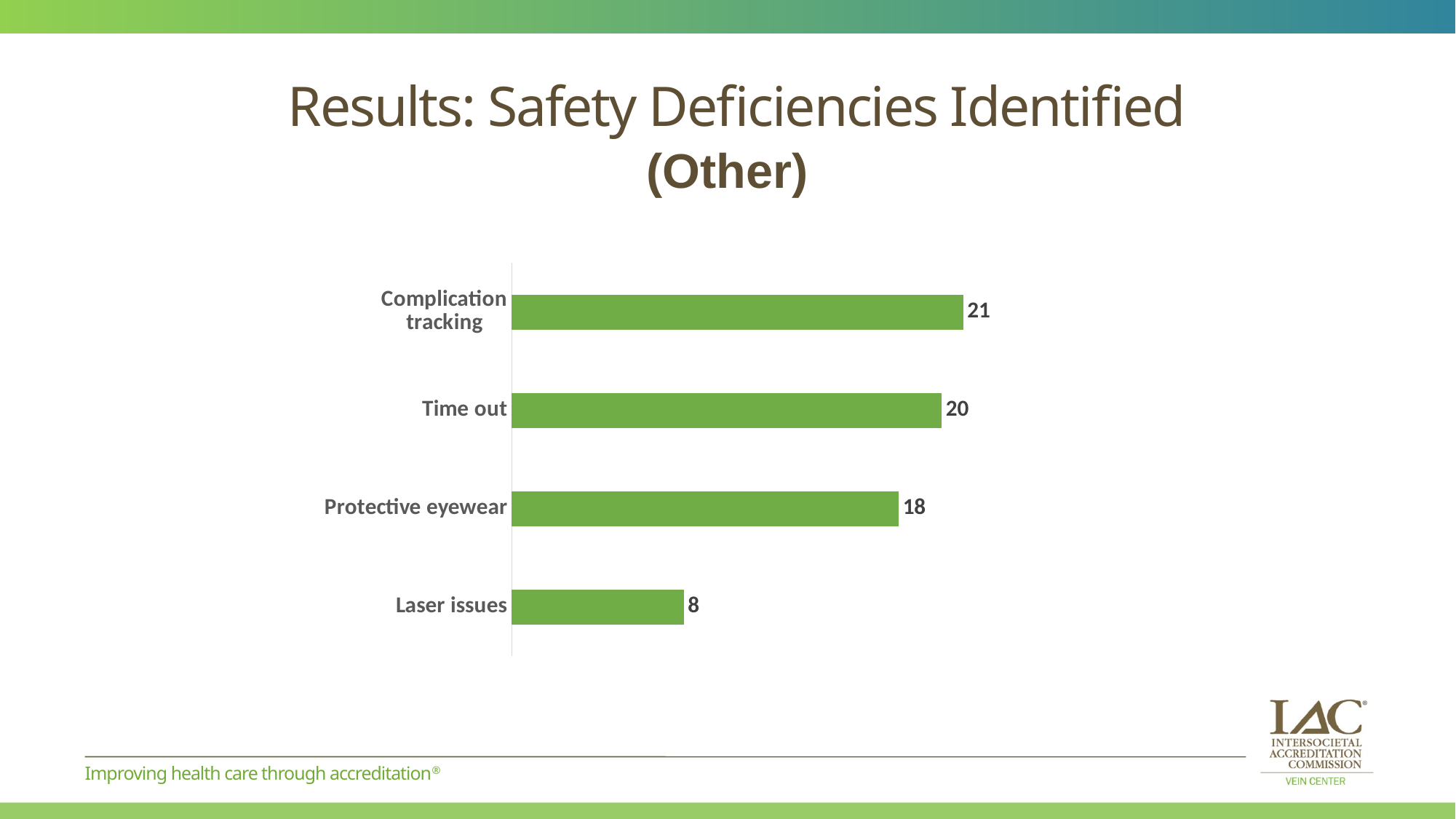
What is the difference between the values for Complication tracking and Laser issues? 13 Which is larger, the value for Protective eyewear or the value for Laser issues? Protective eyewear What kind of chart is shown on the slide? Bar chart What is the title of the slide containing the chart? Results: Safety Deficiencies Identified (Other) What is the value for Time out? 20 Which category has the lowest value? Laser issues What is the value for Laser issues? 8 What is the value for Protective eyewear? 18 What is the value for Complication tracking? 21 Which category has the highest value? Complication tracking How many categories are shown in the chart? 4 What is the difference between the values for Time out and Protective eyewear? 2